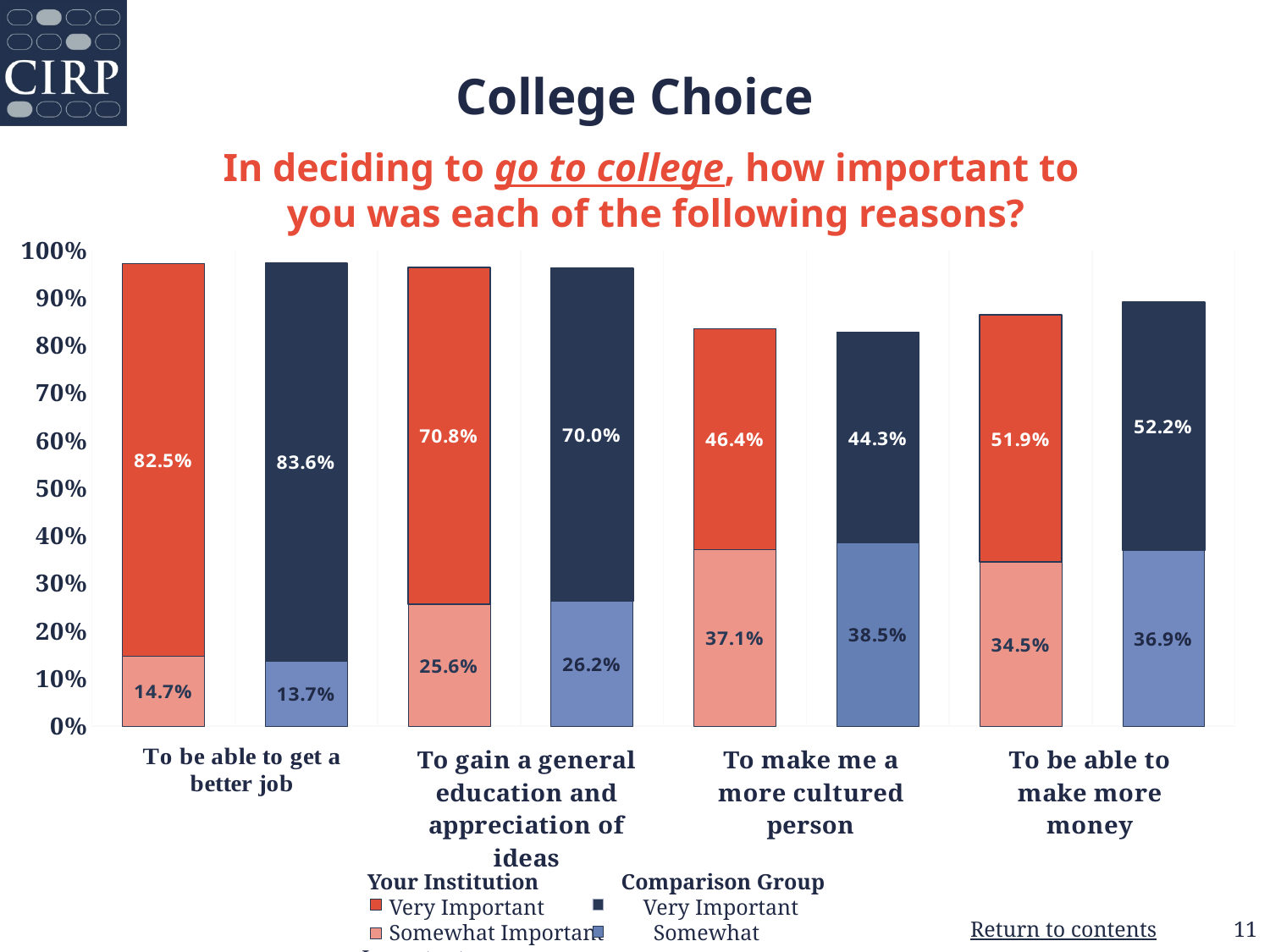
For "To gain a general education and appreciation of ideas", which is larger: the Your Institution Very Important percentage or the Comparison Group Very Important percentage? Your Institution (70.8%) What is the combined Very Important and Somewhat Important total for Your Institution for "To be able to make more money"? 86.4% What type of chart is shown on the slide? Stacked bar chart What is the difference between the Your Institution and Comparison Group Very Important percentages for "To make me a more cultured person"? 2.1% What is the Very Important percentage for the Comparison Group for "To be able to make more money"? 52.2% What is the combined Very Important and Somewhat Important total for the Comparison Group for "To be able to get a better job"? 97.3% How many series does the chart legend list? 4 What percentage of Your Institution students rated "To be able to get a better job" as Very Important? 82.5% What percentage of the Comparison Group rated "To make me a more cultured person" as Somewhat Important? 38.5% Which reason has the lowest Very Important percentage for the Comparison Group? To make me a more cultured person How many reasons (categories) are shown on the x axis of the chart? 4 Which reason has the highest Very Important percentage for Your Institution? To be able to get a better job